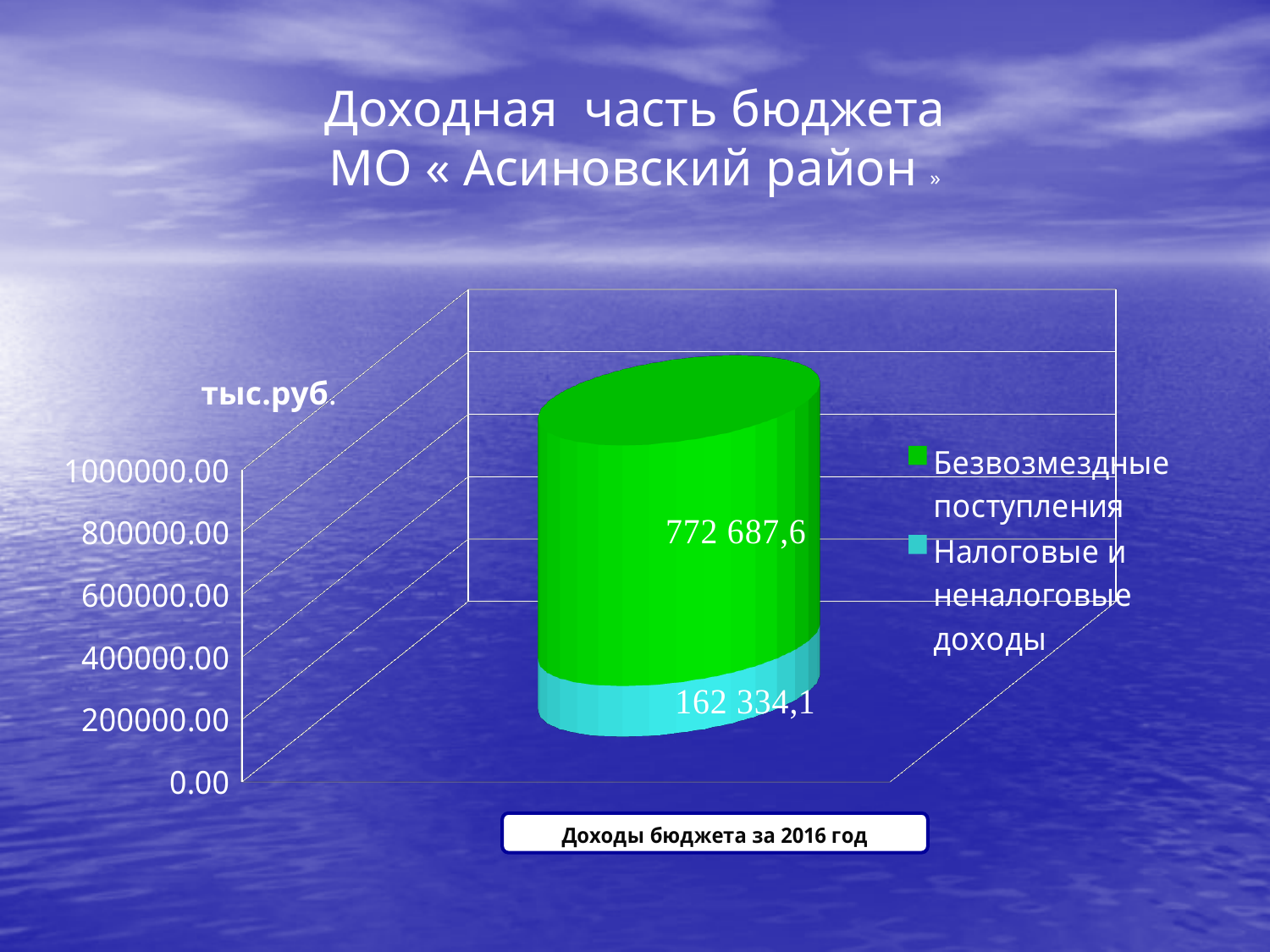
How many categories are shown on the x axis? 1 What is the category label shown below the chart? Доходы бюджета за 2016 год What is the value for Безвозмездные поступления? 772 687,6 What is the total of the stacked bar for Доходы бюджета за 2016 год? 935 021,7 What is the value for Налоговые и неналоговые доходы? 162 334,1 Is the total height of the stacked bar greater or less than 1000000.00? less What kind of chart is shown on the slide? Stacked bar chart Which series has the smallest value in the chart? Налоговые и неналоговые доходы Which series has the larger value, Безвозмездные поступления or Налоговые и неналоговые доходы? Безвозмездные поступления How many series does the legend list? 2 What is the difference between Безвозмездные поступления and Налоговые и неналоговые доходы? 610 353,5 What unit is shown on the vertical axis label? тыс.руб.